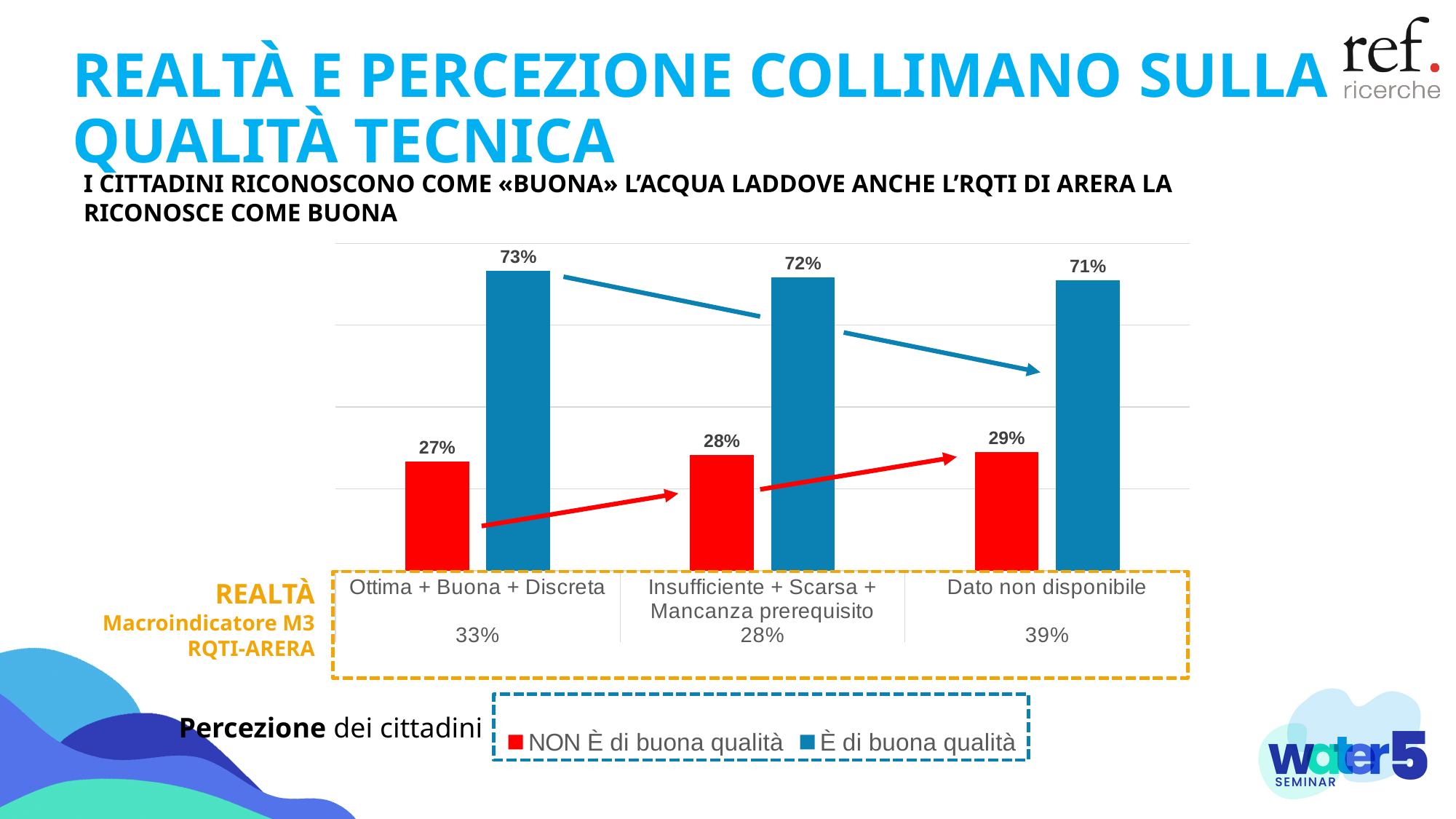
What kind of chart is shown on the slide? bar chart What is the value of "NON È di buona qualità" for the category "Dato non disponibile"? 29% Which colour represents the series "NON È di buona qualità" in the chart? red How many series does the legend list? 2 Do the values of "È di buona qualità" rise or fall from left to right across the categories? fall Which category has the lowest value for "NON È di buona qualità"? Ottima + Buona + Discreta What is the value of "È di buona qualità" for the category "Insufficiente + Scarsa + Mancanza prerequisito"? 72% Which category has the highest value for "È di buona qualità"? Ottima + Buona + Discreta What is the difference between "È di buona qualità" and "NON È di buona qualità" for the category "Dato non disponibile"? 42% How many categories are shown on the x axis of the chart? 3 Which is larger for the category "Insufficiente + Scarsa + Mancanza prerequisito": "NON È di buona qualità" or "È di buona qualità"? È di buona qualità What is the value of "È di buona qualità" for the category "Ottima + Buona + Discreta"? 73%